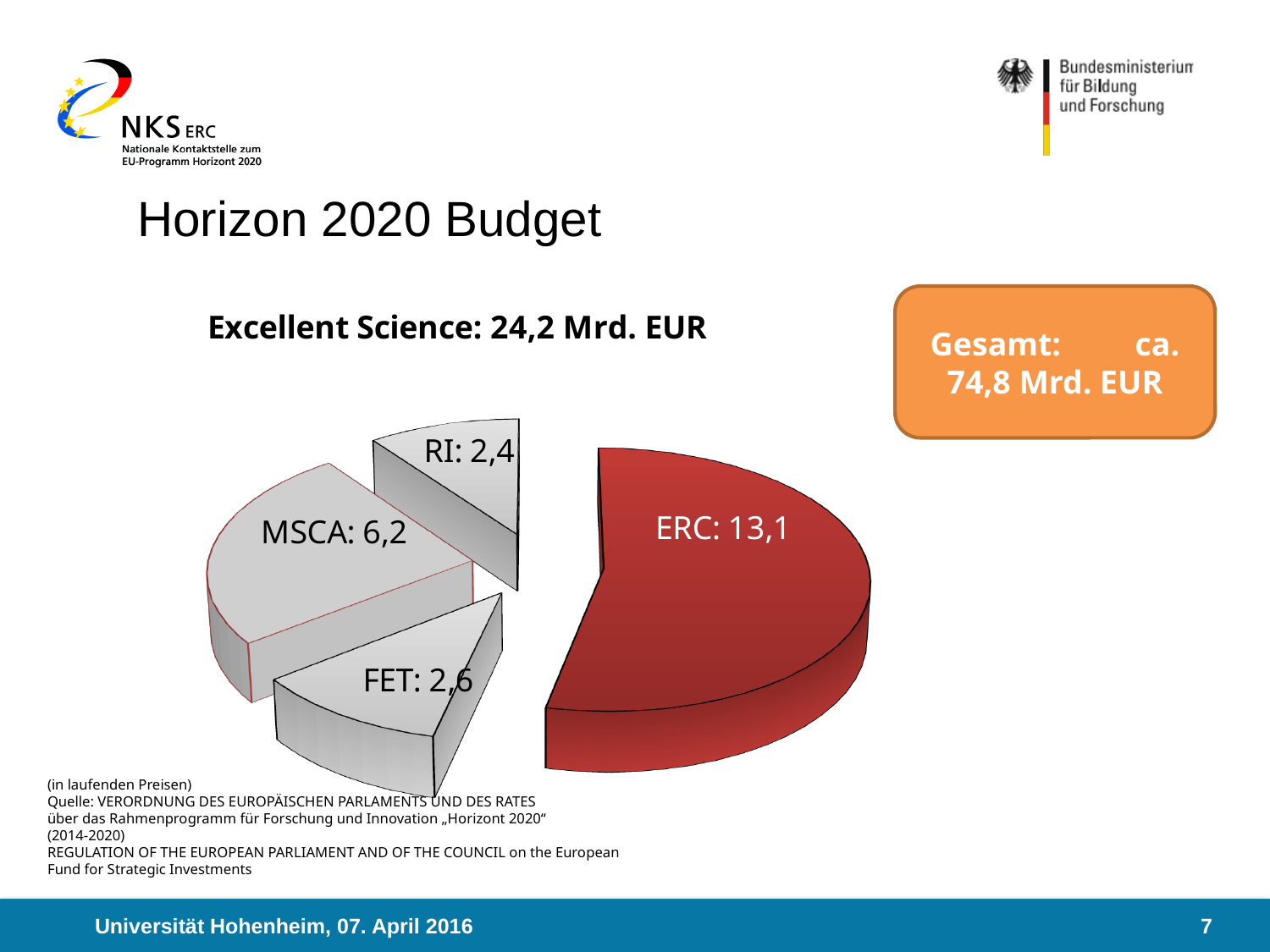
What is the title shown above the pie chart? Excellent Science: 24,2 Mrd. EUR Which slice of the pie chart has the largest value? ERC What is the value shown for ERC in the pie chart? 13,1 Which is larger in the pie chart, the value for FET or the value for RI? FET What is the value shown for RI in the pie chart? 2,4 What is the value shown for FET in the pie chart? 2,6 What is the difference between the ERC value and the MSCA value in the pie chart? 6,9 What is the difference between the FET value and the RI value in the pie chart? 0,2 What is the value shown for MSCA in the pie chart? 6,2 What kind of chart is shown on the slide? Pie chart How many slices does the pie chart have? 4 Which slice of the pie chart has the smallest value? RI